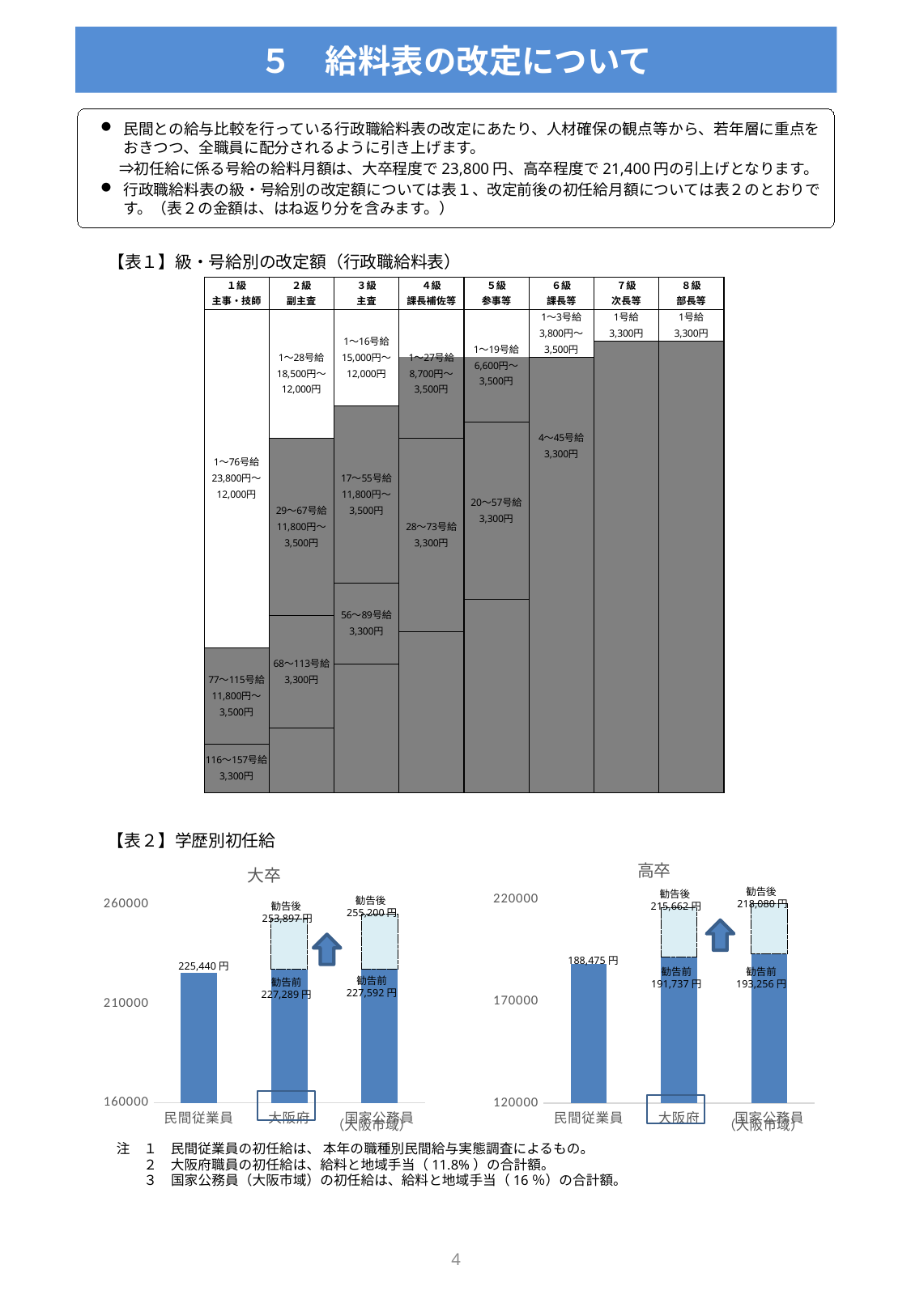
In the 高卒 chart, which category has the lowest value? 民間従業員 In the 大卒 chart, what is the 勧告前 value for 国家公務員 (大阪市域)? 227,592 円 In the 高卒 chart, what is the difference between the 勧告後 and 勧告前 values for 大阪府? 23,925 円 In the 高卒 chart, what is the value for 民間従業員? 188,475 円 In the 高卒 chart, what is the 勧告前 value for 大阪府? 191,737 円 In the 大卒 chart, what is the value for 民間従業員? 225,440 円 What kind of chart is the 高卒 chart? bar chart In the 高卒 chart, what is the 勧告後 value for 国家公務員 (大阪市域)? 218,080 円 In the 大卒 chart, which is larger: the 勧告後 value for 大阪府 or the 勧告後 value for 国家公務員 (大阪市域)? 国家公務員 (大阪市域) In the 大卒 chart, what is the 勧告後 value for 大阪府? 253,897 円 In the 大卒 chart, what is the difference between the 勧告後 and 勧告前 values for 大阪府? 26,608 円 How many categories are shown on the x axis of the 大卒 chart? 3